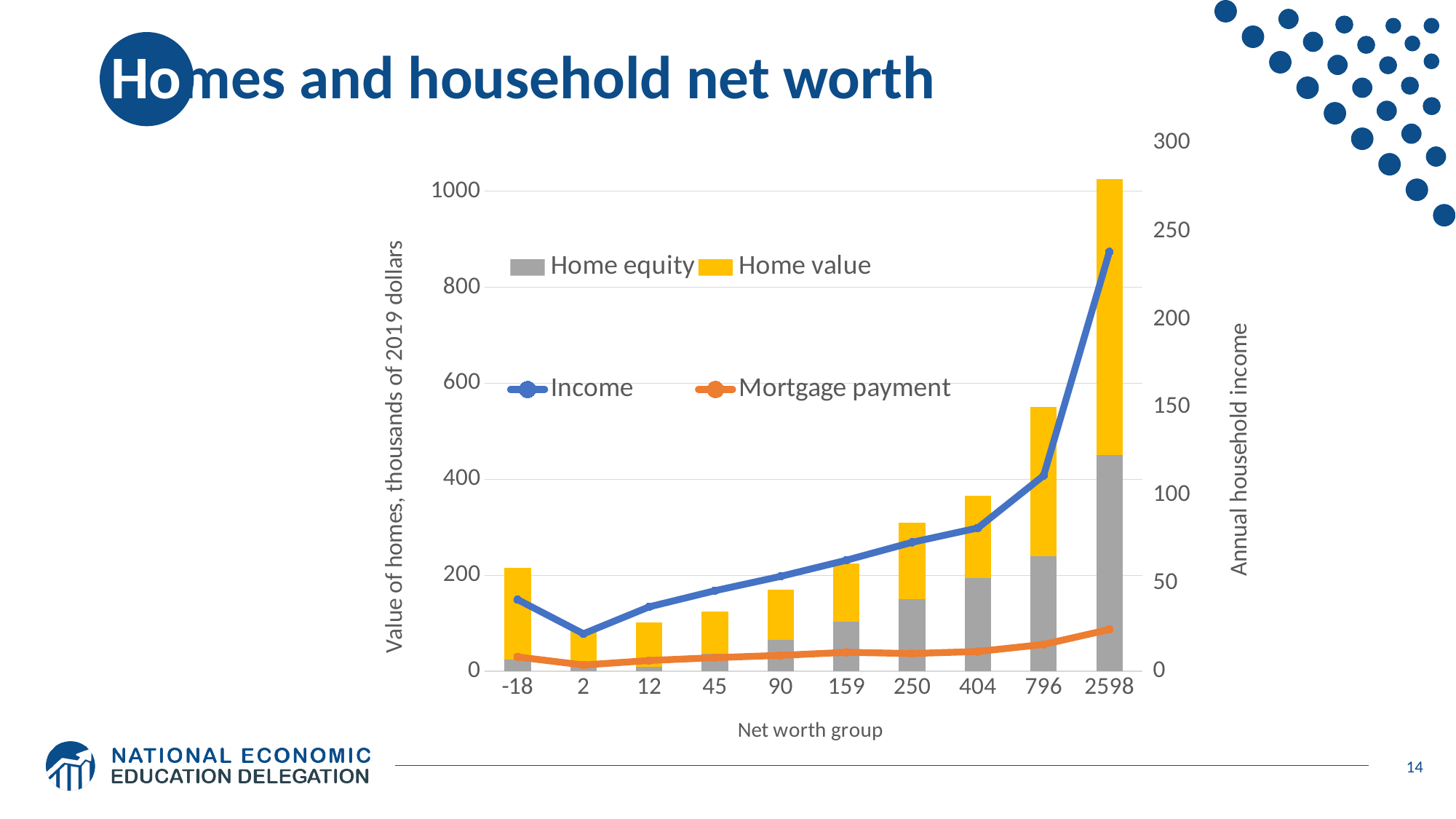
Is the Home value for net worth group 2598 greater or less than 800? less What kind of chart is shown on the slide? A combination bar and line chart Which net worth group has the lowest Income? 2 Which net worth group has the lowest Home value? 2 Is the Income for net worth group 2598 greater or less than 200 on the right axis? greater How many net worth groups are shown on the x axis? 10 Which net worth group has the highest Home value? 2598 How many series does the legend list? 4 Is the Home value for net worth group 2 greater or less than 100? less Which is larger, the Home value for net worth group 796 or for net worth group 404? 796 Does the Income line generally rise or fall from net worth group 2 to net worth group 2598? rise